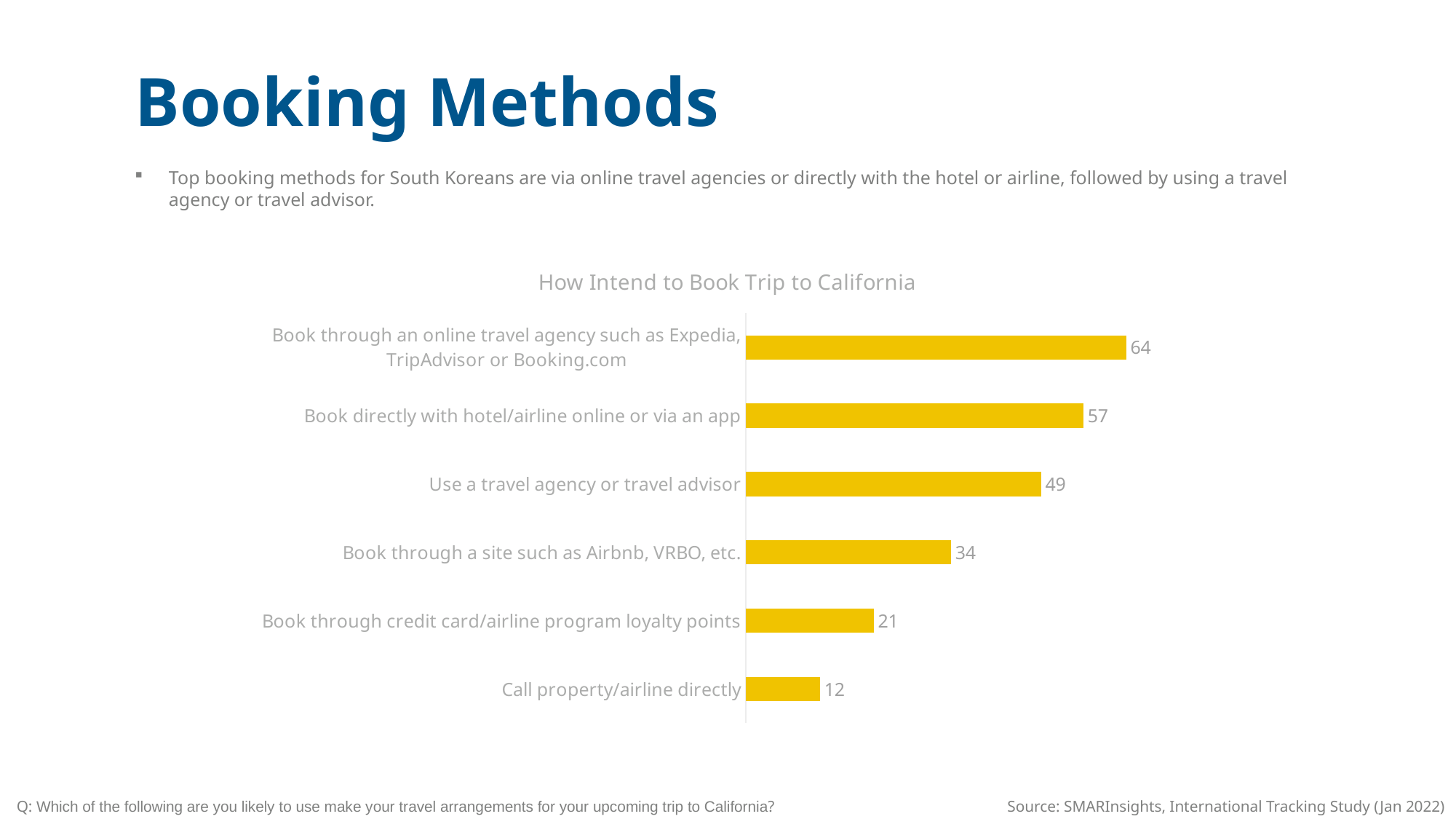
How many booking methods are shown in the chart? 6 What kind of chart is shown on the slide? Bar chart Which booking method has the lowest value? Call property/airline directly What is the title of the chart? How Intend to Book Trip to California What is the value for "Call property/airline directly"? 12 What is the difference between the values for booking through an online travel agency and booking directly with hotel/airline online or via an app? 7 Which booking method has the highest value? Book through an online travel agency such as Expedia, TripAdvisor or Booking.com What is the difference between the values for "Book through a site such as Airbnb, VRBO, etc." and "Book through credit card/airline program loyalty points"? 13 What is the value for "Use a travel agency or travel advisor"? 49 What colour are the bars in the chart? Yellow What is the value for "Book directly with hotel/airline online or via an app"? 57 Which is larger: the value for "Use a travel agency or travel advisor" or the value for "Book through a site such as Airbnb, VRBO, etc."? Use a travel agency or travel advisor